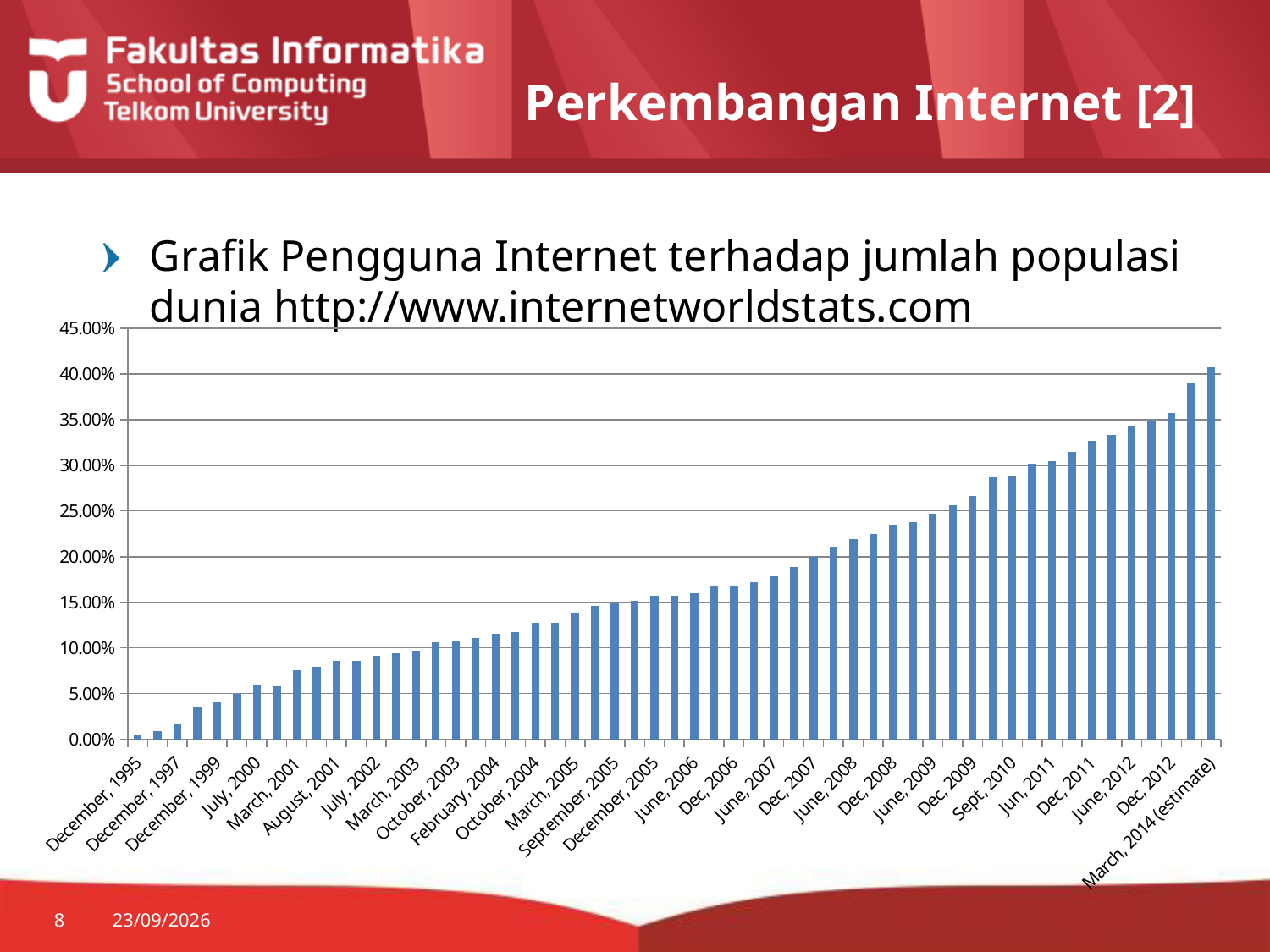
Is the value for Sept, 2010 greater or less than 30.00%? less What is the highest tick value shown on the vertical axis? 45.00% Is the value for July, 2002 greater or less than 10.00%? less What kind of chart is shown on the slide? bar chart Is the value for Dec, 2009 greater or less than 25.00%? greater Do the values generally rise or fall from left to right along the x axis? rise Which category has the highest value in the chart? March, 2014 (estimate) Which is larger, the value for Dec, 2012 or the value for December, 1997? Dec, 2012 Which category has the lowest value in the chart? December, 1995